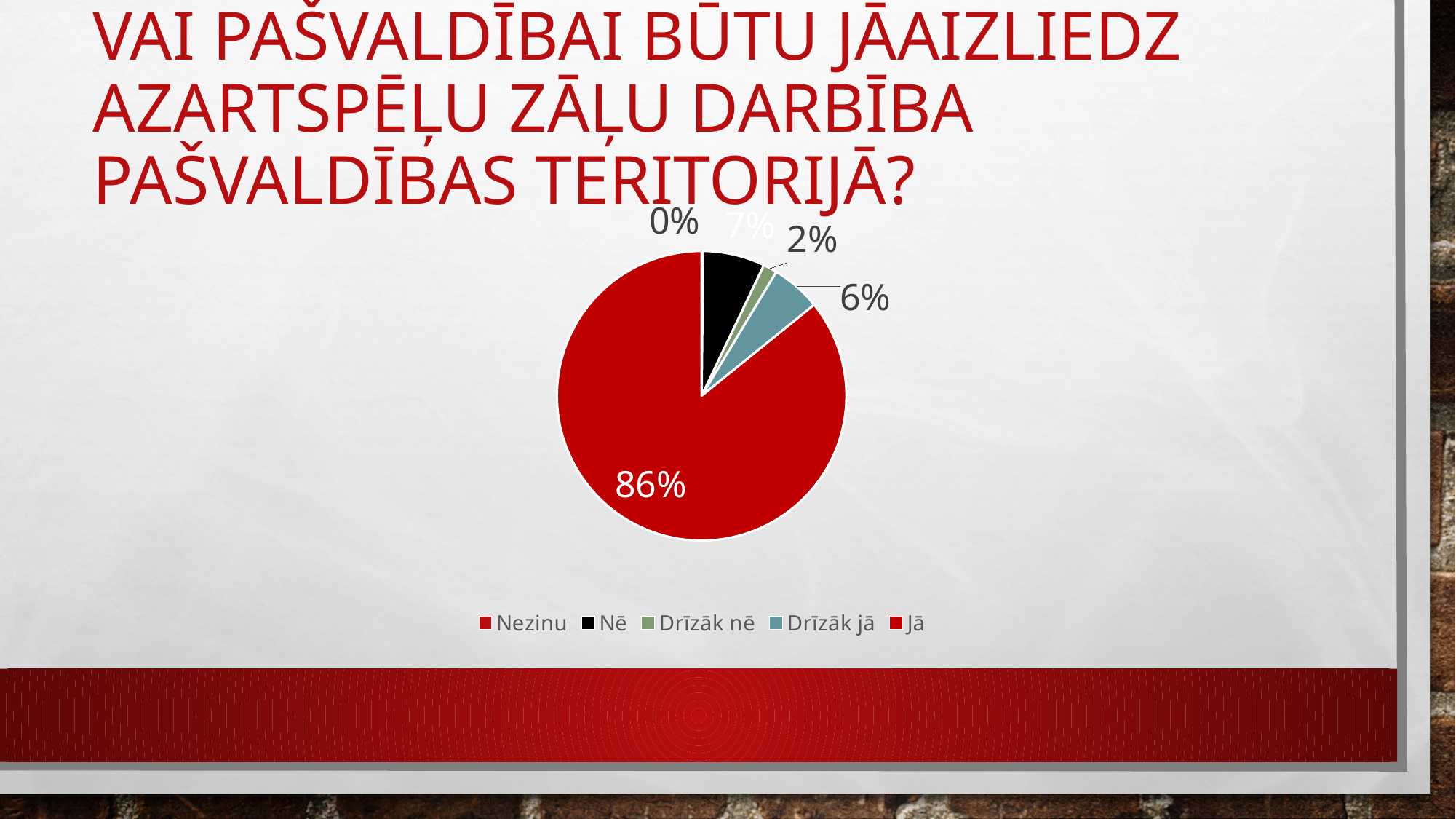
What share of the pie does the "Jā" slice represent? 86% Which category has the largest slice of the pie? Jā What is the value shown for "Nē"? 7% What is the value shown for "Drīzāk jā"? 6% Which is larger, the value for "Drīzāk jā" or the value for "Drīzāk nē"? Drīzāk jā What colour is the "Nē" slice in the pie chart? black What is the value shown for "Nezinu"? 0% What is the value shown for "Drīzāk nē"? 2% What kind of chart is shown on the slide? pie chart Which category has the smallest slice of the pie? Nezinu What is the difference between the values for "Jā" and "Nē"? 79% How many categories does the legend list? 5